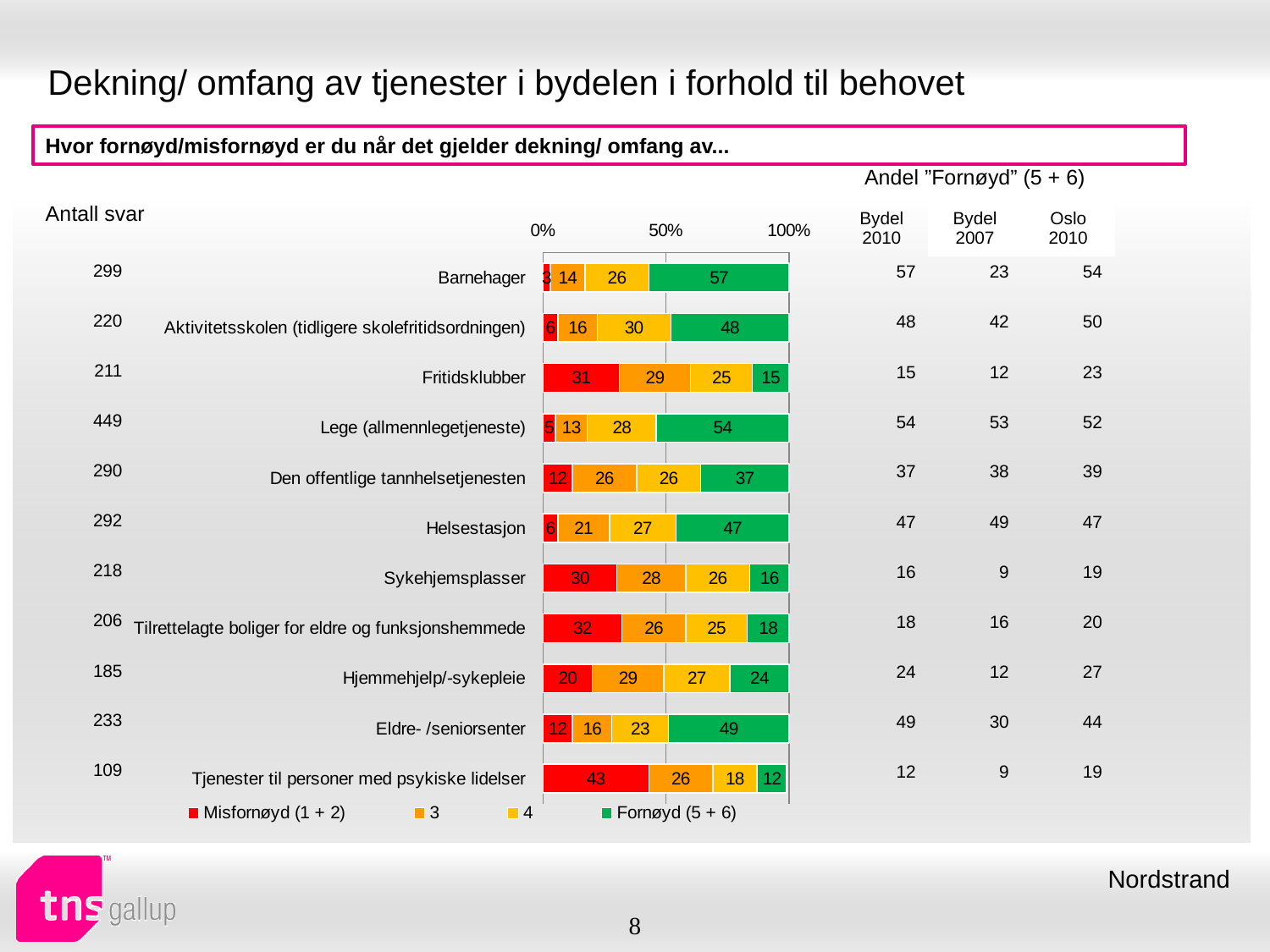
What is the value of the "Misfornøyd (1 + 2)" segment for Fritidsklubber? 31 Which category has the lowest "Fornøyd (5 + 6)" value? Tjenester til personer med psykiske lidelser What is the total of the stacked bar for Hjemmehjelp/-sykepleie? 100 What is the difference between the "Fornøyd (5 + 6)" values for Barnehager and Fritidsklubber? 42 How many categories are shown in the chart? 11 Which has a larger "Fornøyd (5 + 6)" value, Sykehjemsplasser or Hjemmehjelp/-sykepleie? Hjemmehjelp/-sykepleie How many series does the legend list? 4 Which category has the highest "Fornøyd (5 + 6)" value? Barnehager What is the value of the "Fornøyd (5 + 6)" segment for Barnehager? 57 What is the value of the "4" segment for Aktivitetsskolen (tidligere skolefritidsordningen)? 30 What kind of chart is shown on the slide? Stacked bar chart Which category has the highest "Misfornøyd (1 + 2)" value? Tjenester til personer med psykiske lidelser